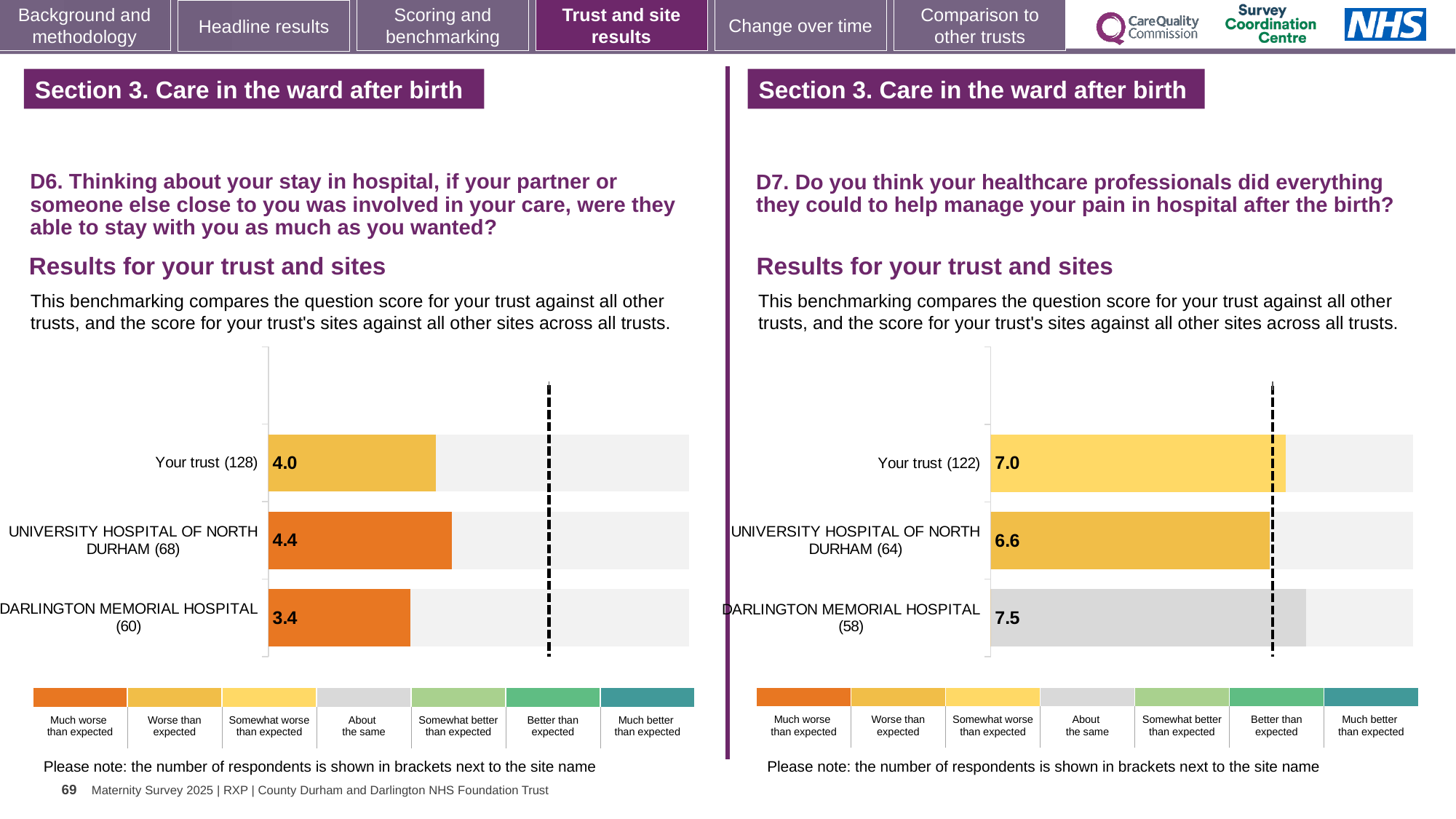
In the D7 chart on the right, what is the score for DARLINGTON MEMORIAL HOSPITAL (58)? 7.5 In the D7 chart on the right, which has the larger score: Your trust or UNIVERSITY HOSPITAL OF NORTH DURHAM? Your trust In the D7 chart on the right, which benchmark category does the colour of the DARLINGTON MEMORIAL HOSPITAL bar correspond to in the legend? About the same How many bars are plotted in the D6 chart on the left? 3 In the D7 chart on the right, what is the difference between the scores for DARLINGTON MEMORIAL HOSPITAL and Your trust? 0.5 In the D6 chart on the left, what is the difference between the scores for UNIVERSITY HOSPITAL OF NORTH DURHAM and DARLINGTON MEMORIAL HOSPITAL? 1.0 In the D6 chart on the left, which site or trust has the lowest score? DARLINGTON MEMORIAL HOSPITAL (60) In the D7 chart on the right, what is the score for Your trust (122)? 7.0 In the D6 chart on the left, what is the score for Your trust (128)? 4.0 What kind of chart is used for the D7 results on the right? Bar chart In the D7 chart on the right, which site or trust has the highest score? DARLINGTON MEMORIAL HOSPITAL (58) In the D6 chart on the left, what is the score for UNIVERSITY HOSPITAL OF NORTH DURHAM (68)? 4.4